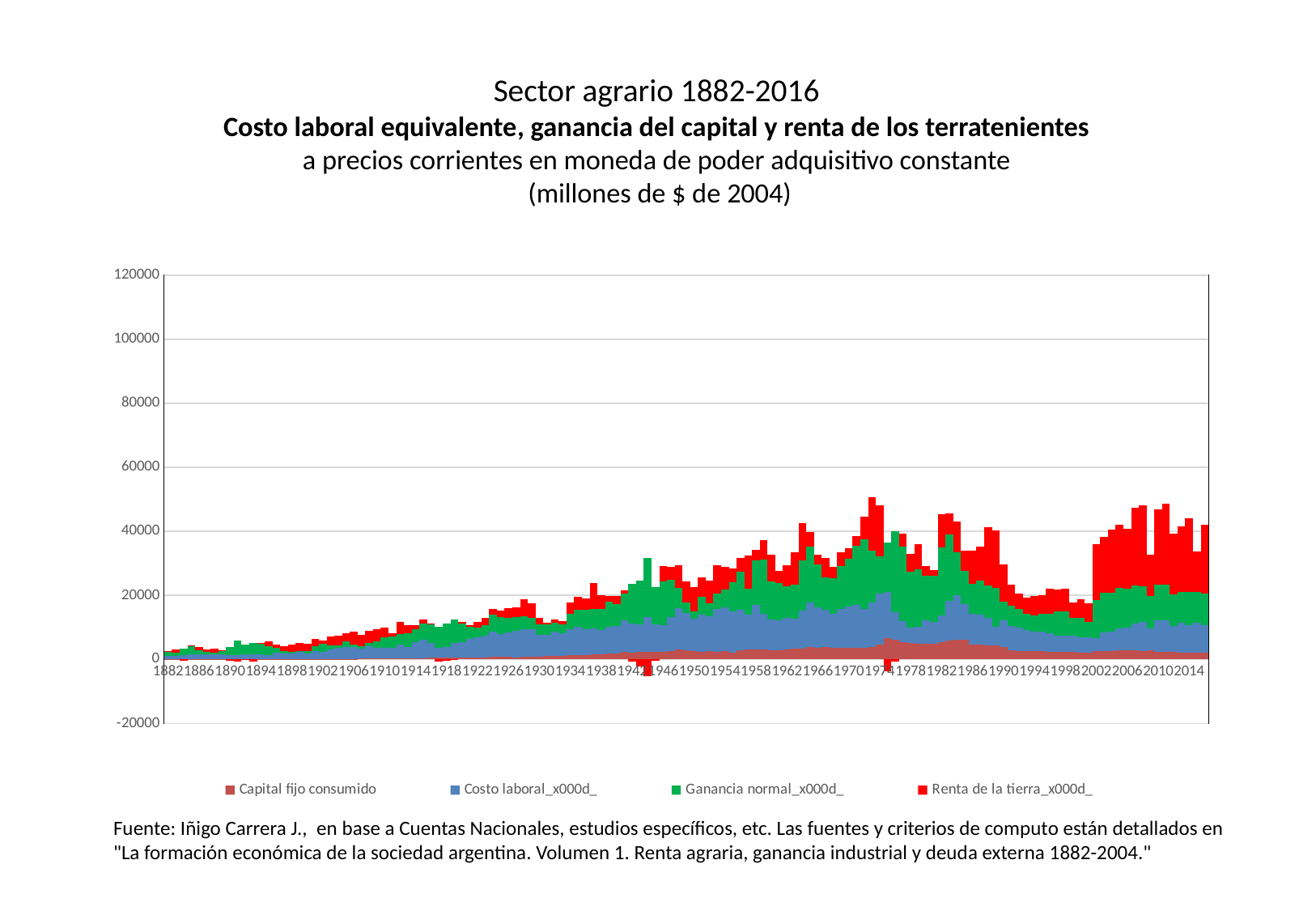
How many series does the legend list? 4 Is the total stacked value for 1994 greater or less than 40000? less Which series is shown in red in the chart? Renta de la tierra_x000d_ Which series is shown in blue in the chart? Costo laboral_x000d_ What is the highest value shown on the vertical axis? 120000 What is the first year shown on the horizontal axis? 1882 Is the total stacked value for 2014 larger or smaller than the total for 1882? larger What kind of chart is shown on the slide? Stacked bar chart Overall, do the total stacked values rise or fall from 1882 to 2016? rise Is the total stacked value for 1974 greater or less than 40000? greater What is the lowest value shown on the vertical axis? -20000 Is the total stacked value for 1882 greater or less than 20000? less